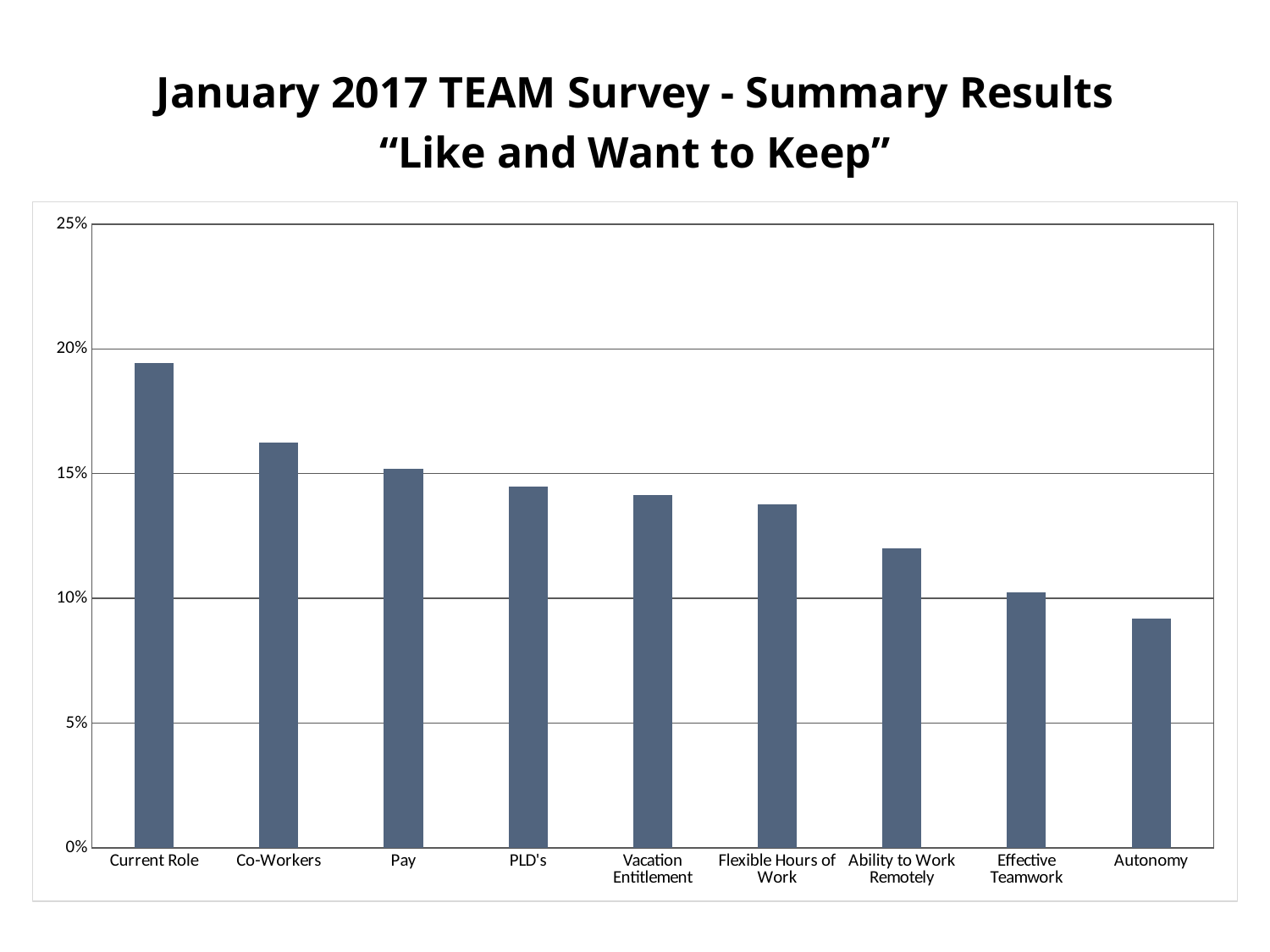
Is the value for Ability to Work Remotely greater or less than 15%? less Which has a larger value, Current Role or Co-Workers? Current Role Which category has the highest value in the chart? Current Role Which has a larger value, Effective Teamwork or Pay? Pay Do the values rise or fall moving from left to right along the x axis? Fall What is the title of the slide containing the chart? January 2017 TEAM Survey - Summary Results "Like and Want to Keep" How many categories are shown on the x axis of the chart? 9 Is the value for Co-Workers greater or less than 15%? greater What kind of chart is shown on the slide? Bar chart Is the value for Autonomy greater or less than 10%? less Which category has the lowest value in the chart? Autonomy